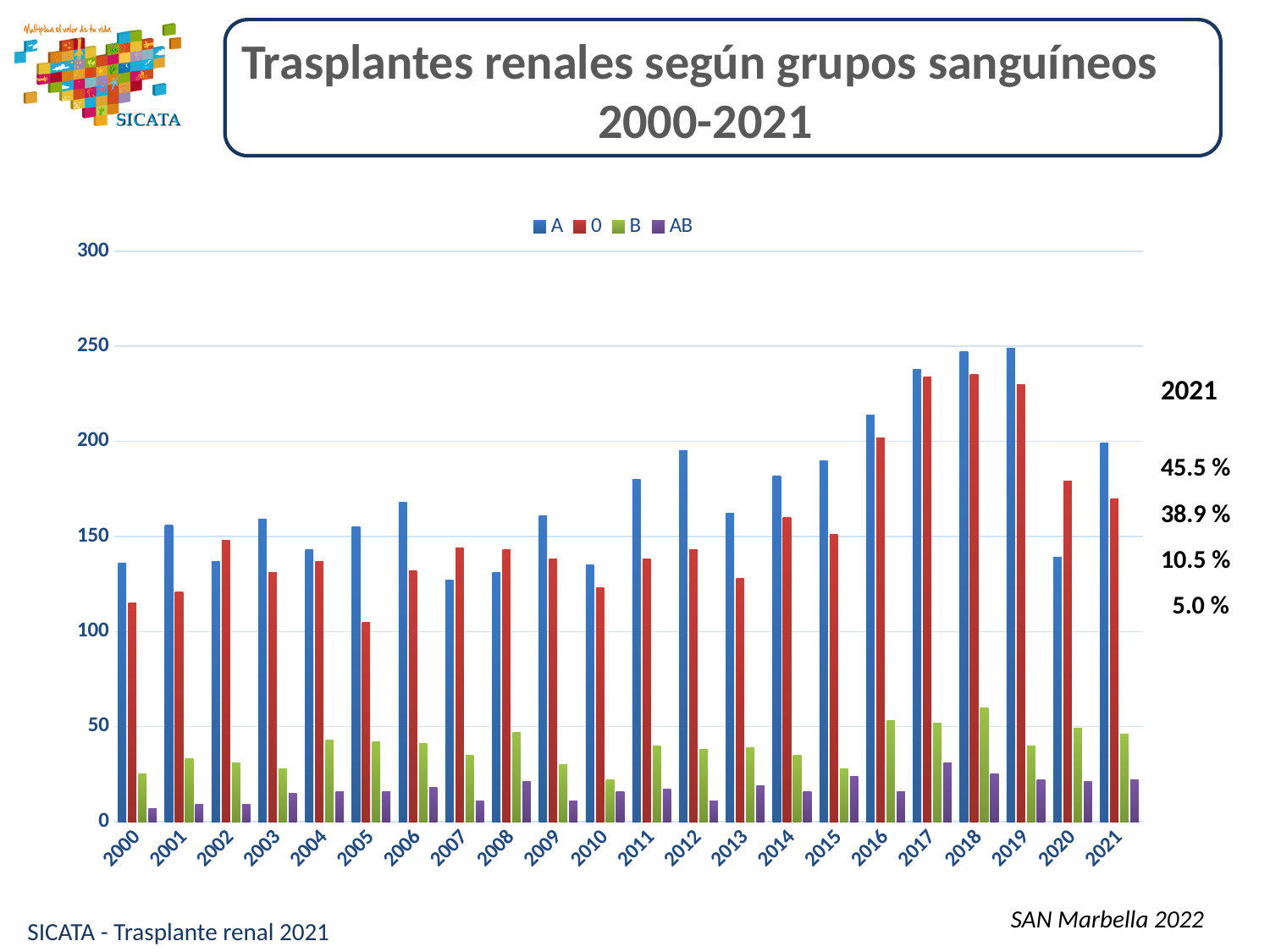
In which year is the value for series B the highest? 2018 In 2020, which series has the larger value, A or 0? 0 What percentage is shown for the first (largest) group in the 2021 annotation on the right of the chart? 45.5 % Is the value for series A in 2019 greater or less than 200? greater What kind of chart is shown on the slide? bar chart Is the value for series B in 2018 greater or less than 50? greater Is the value for series 0 in 2005 greater or less than 150? less How many series does the legend list? 4 How many years are shown along the x axis? 22 In which year is the value for series 0 the lowest? 2005 Which series are listed in the legend? A, 0, B, AB